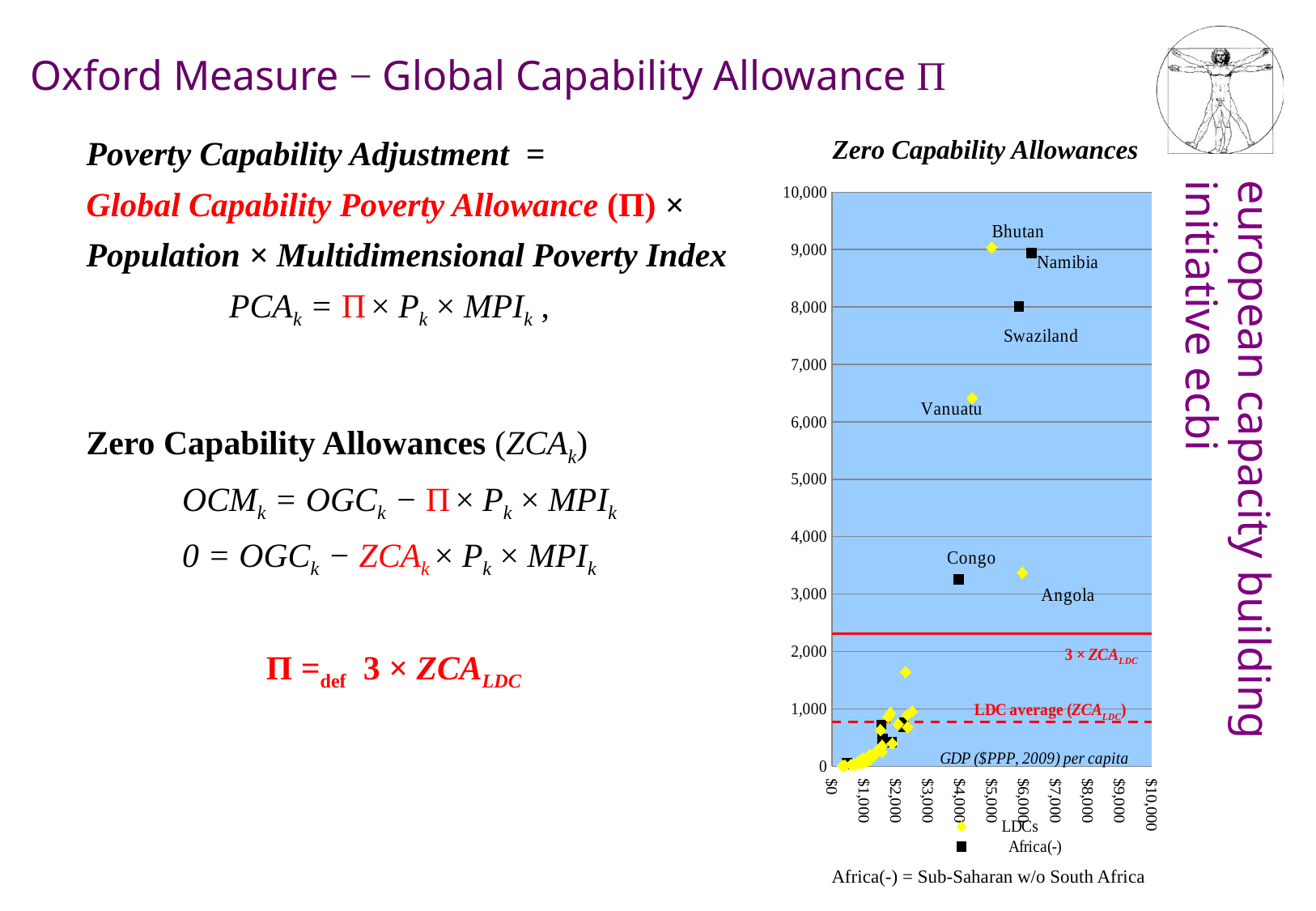
What kind of chart is shown under the title 'Zero Capability Allowances'? scatter chart In the 'Zero Capability Allowances' chart, is the value for Vanuatu greater or less than 6,000? greater In the 'Zero Capability Allowances' chart, which has the higher value, Swaziland or Angola? Swaziland In the 'Zero Capability Allowances' chart, is the value for Congo greater or less than 4,000? less How many series does the legend of the 'Zero Capability Allowances' chart list? 2 In the 'Zero Capability Allowances' chart, is the value for Swaziland greater or less than 7,000? greater What is the x-axis label of the 'Zero Capability Allowances' chart? GDP ($PPP, 2009) per capita What are the two series named in the legend of the 'Zero Capability Allowances' chart? LDCs and Africa(-) In the 'Zero Capability Allowances' chart, which has the higher value, Bhutan or Vanuatu? Bhutan